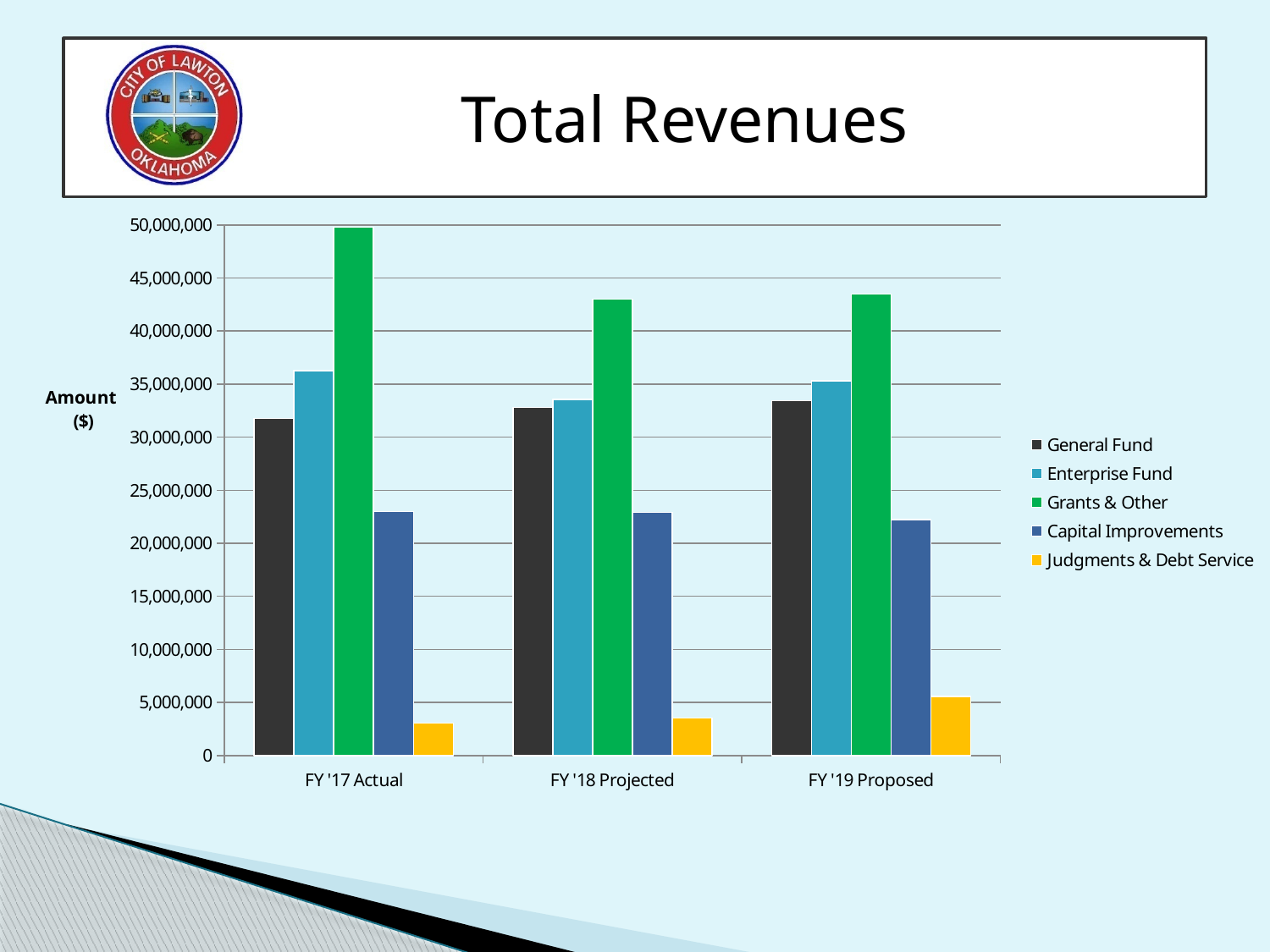
Is Grants & Other larger in FY '17 Actual or FY '18 Projected? FY '17 Actual Is the value for Grants & Other in FY '17 Actual greater or less than 45,000,000? greater Is the value for Judgments & Debt Service in FY '19 Proposed greater or less than 10,000,000? less What is the label on the vertical axis? Amount ($) Which series has the highest value in FY '17 Actual? Grants & Other What kind of chart is shown on the slide? Bar chart Is the value for Capital Improvements in FY '18 Projected greater or less than 25,000,000? less Do the Judgments & Debt Service values rise or fall from FY '17 Actual to FY '19 Proposed? Rise How many series does the legend list? 5 Which series has the lowest value in FY '19 Proposed? Judgments & Debt Service How many fiscal year categories are shown on the x axis? 3 In FY '17 Actual, which is larger: General Fund or Enterprise Fund? Enterprise Fund